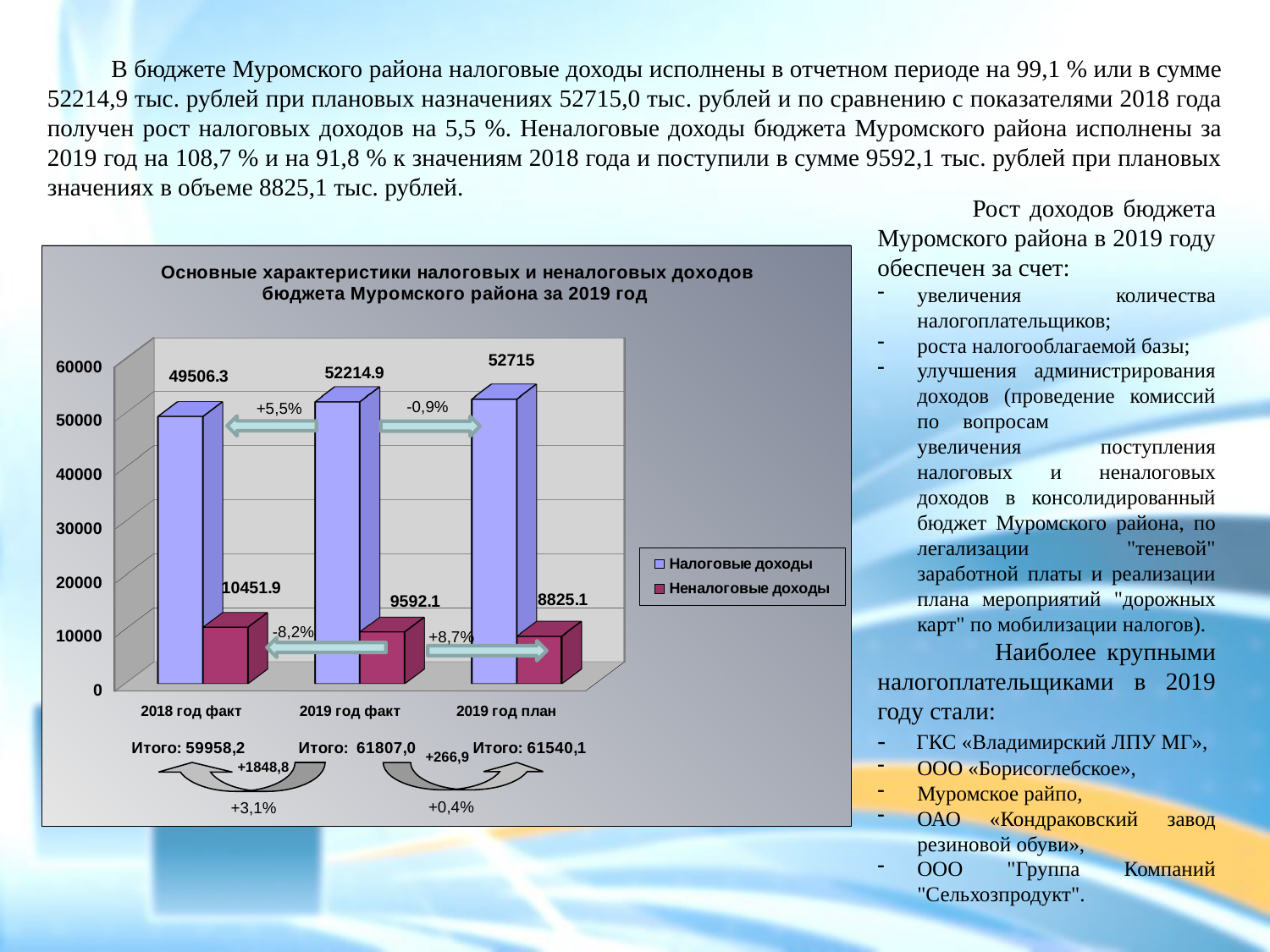
What is the difference between Налоговые доходы for 2019 год факт and 2018 год факт? 2708.6 Which category has the highest value for Налоговые доходы? 2019 год план What is the value of Неналоговые доходы for 2018 год факт? 10451.9 How many series does the legend list? 2 What kind of chart is shown on the slide? bar chart Which is larger: Неналоговые доходы for 2018 год факт or for 2019 год факт? 2018 год факт What is the total (Итого) shown for 2019 год факт? 61807,0 What is the value of Налоговые доходы for 2019 год план? 52715 Is the value of Неналоговые доходы for 2019 год план greater or less than 10000? less What is the value of Налоговые доходы for 2019 год факт? 52214.9 How many categories are shown on the x axis? 3 Which category has the lowest value for Неналоговые доходы? 2019 год план